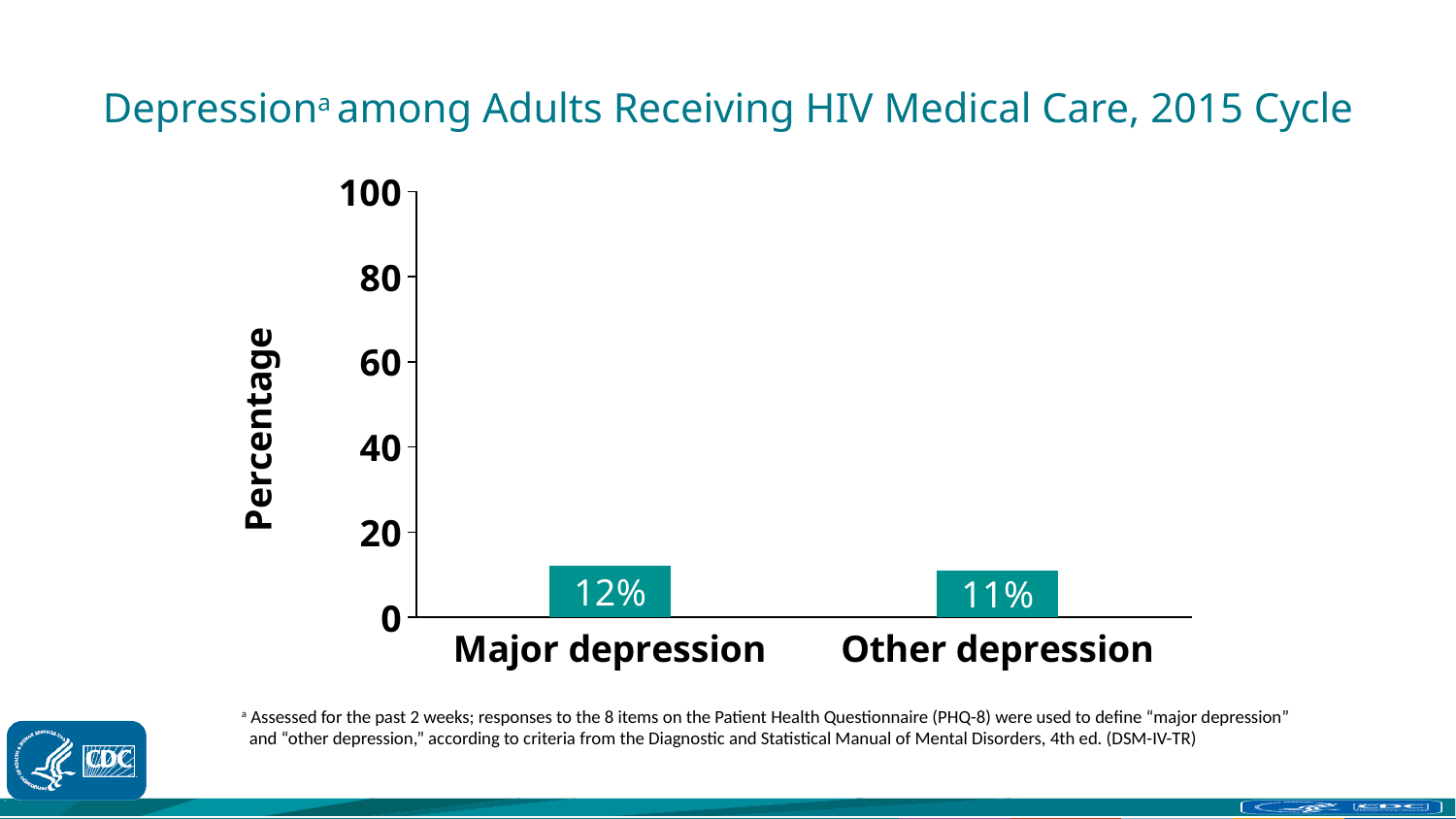
What is the difference in percentage points between major depression and other depression? 1 What is the label of the y axis? Percentage Is the value for major depression greater or less than 20? less What is the maximum value shown on the y axis? 100 What kind of chart is shown on the slide? Bar chart How many categories are shown on the x axis? 2 What percentage of adults receiving HIV medical care had other depression? 11% Which category has the lowest percentage? Other depression Which category has the higher percentage, major depression or other depression? Major depression What percentage of adults receiving HIV medical care had major depression? 12%